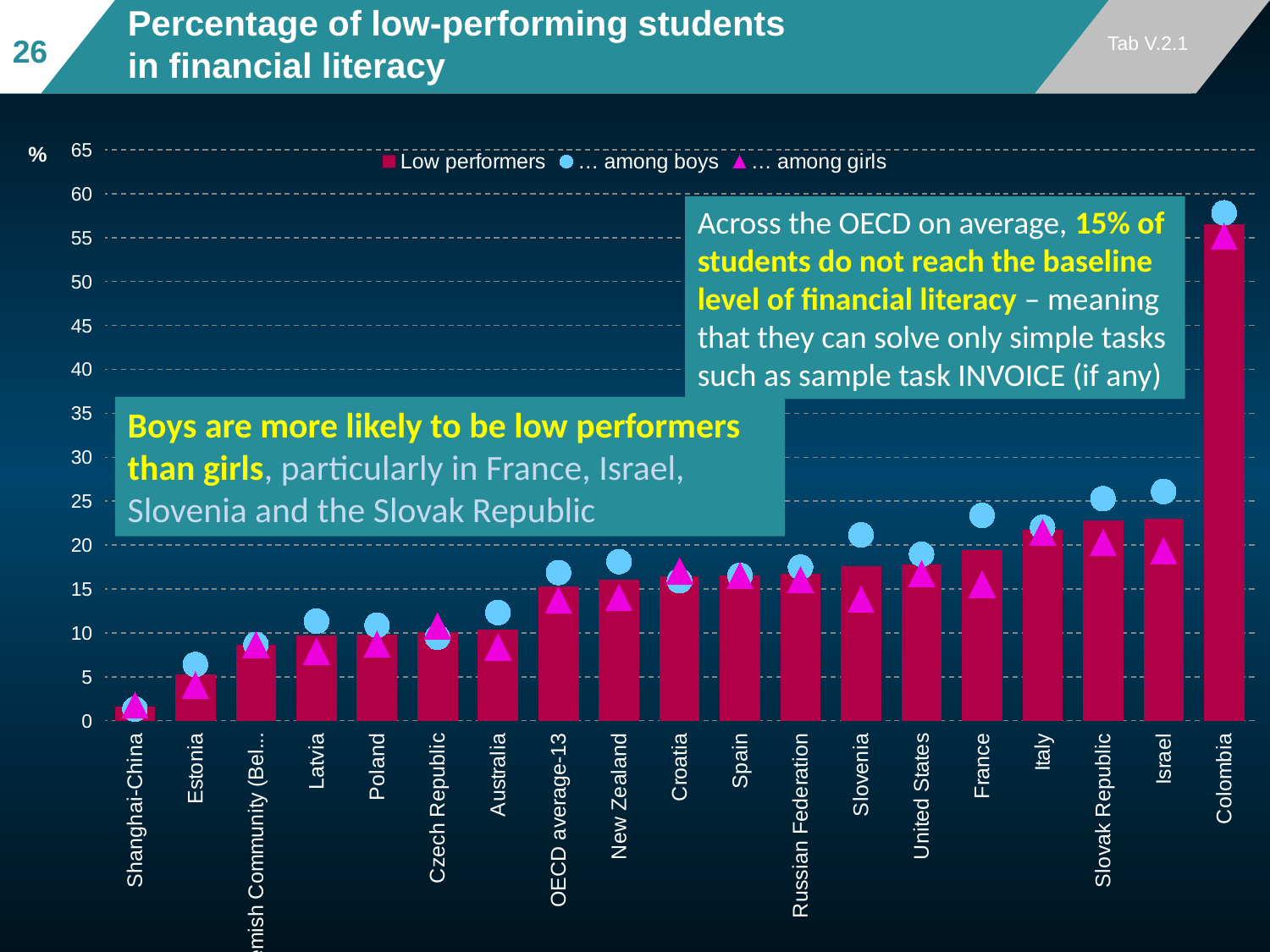
Which has a higher percentage of low performers, Israel or Estonia? Israel Which country has the highest percentage of low performers? Colombia Which country has the lowest percentage of low performers? Shanghai-China What kind of chart is shown on the slide? bar chart Is the value for Low performers in Slovenia greater or less than 20? less Do the Low performers bars rise or fall from left to right along the x axis? rise How many countries or economies are shown on the x axis? 19 Is the value for Low performers in Israel greater or less than 20? greater How many series does the legend list? 3 Is the value for Low performers in Shanghai-China greater or less than 5? less